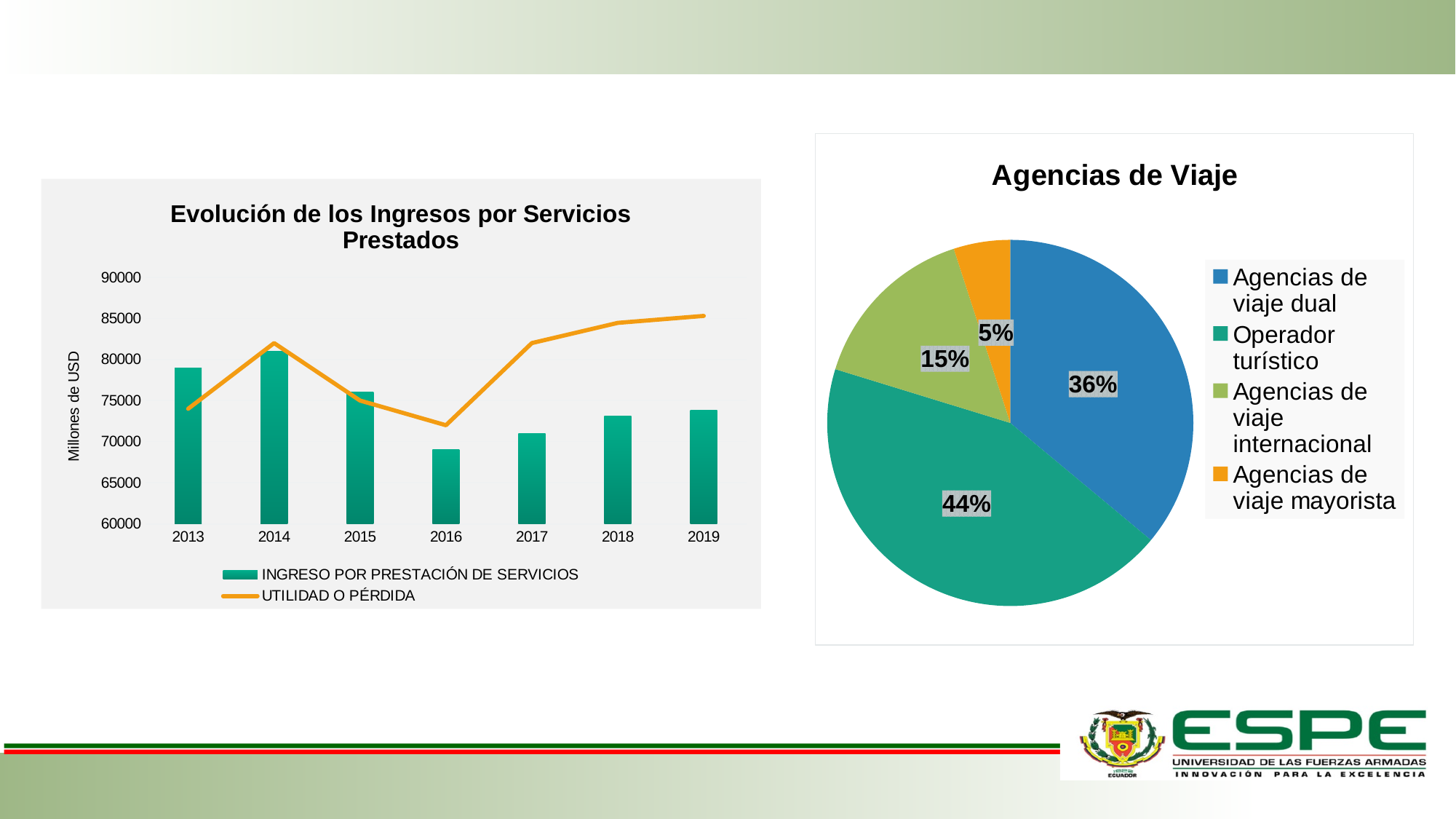
In the pie chart 'Agencias de Viaje', what share does Operador turístico have? 44% In the pie chart 'Agencias de Viaje', what is the difference in percentage points between Agencias de viaje dual and Agencias de viaje internacional? 21 In the chart 'Evolución de los Ingresos por Servicios Prestados', what is the label on the vertical axis? Millones de USD In the pie chart 'Agencias de Viaje', which category has the largest slice? Operador turístico In the chart 'Evolución de los Ingresos por Servicios Prestados', which year has the lowest bar for INGRESO POR PRESTACIÓN DE SERVICIOS? 2016 In the pie chart 'Agencias de Viaje', what percentage is shown for Agencias de viaje mayorista? 5% In the chart 'Evolución de los Ingresos por Servicios Prestados', which year has the tallest bar for INGRESO POR PRESTACIÓN DE SERVICIOS? 2014 In the chart 'Evolución de los Ingresos por Servicios Prestados', is the INGRESO POR PRESTACIÓN DE SERVICIOS bar for 2016 greater or less than 70000? less In the chart 'Evolución de los Ingresos por Servicios Prestados', is the UTILIDAD O PÉRDIDA value for 2018 greater or less than 80000? greater In the chart 'Evolución de los Ingresos por Servicios Prestados', how many series does the legend list? 2 In the pie chart 'Agencias de Viaje', how many categories does the legend list? 4 In the pie chart 'Agencias de Viaje', which category has the smallest slice? Agencias de viaje mayorista